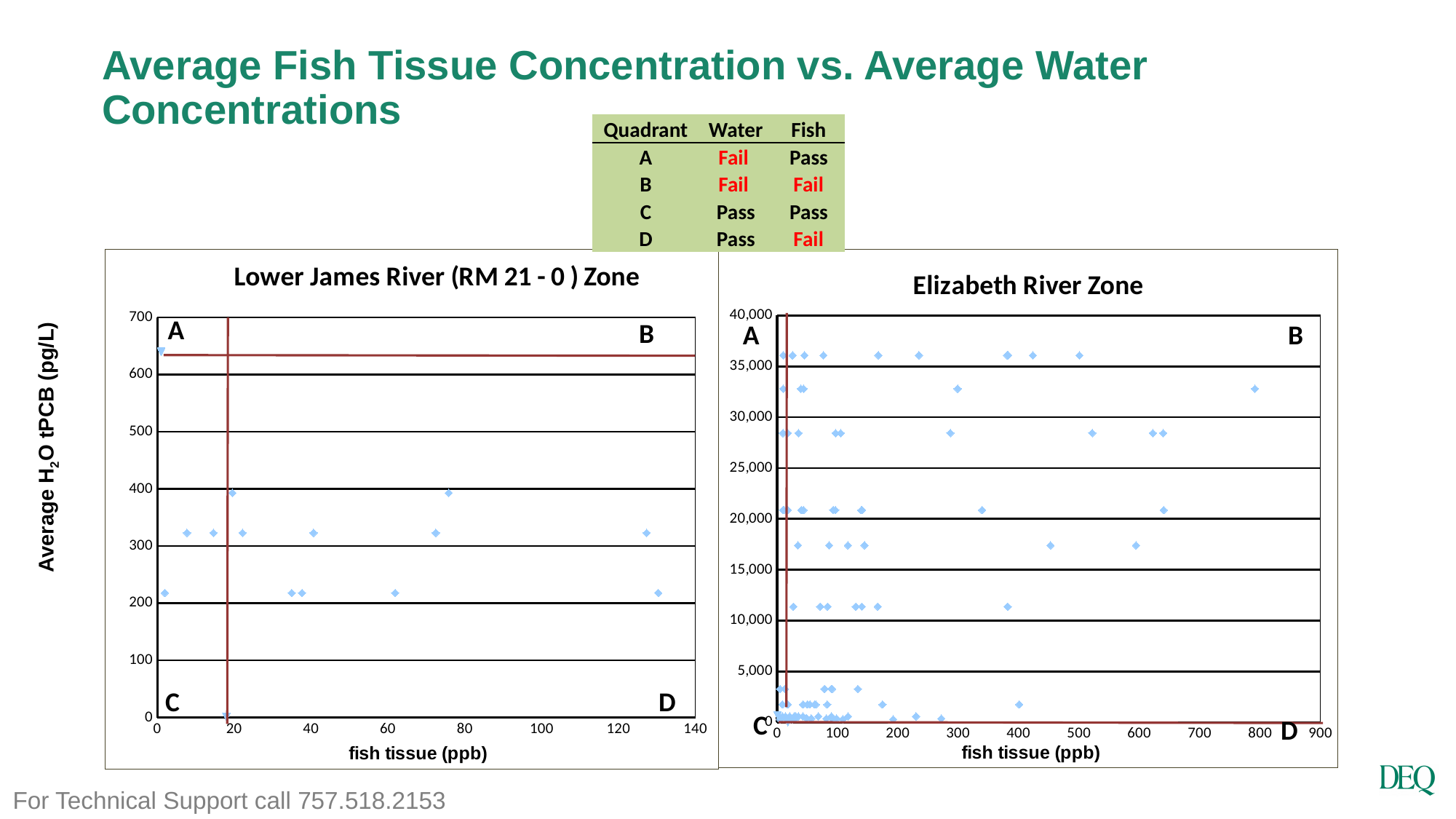
How many scatter charts are shown on the slide? 2 What kind of chart is the Lower James River (RM 21 - 0 ) Zone chart? scatter chart In the Lower James River (RM 21 - 0 ) Zone chart, is the largest fish tissue value plotted greater or less than 120? greater What is the title of the chart on the right of the slide? Elizabeth River Zone What is the label of the horizontal axis on both charts? fish tissue (ppb) Which chart has the larger maximum value on its vertical axis, Lower James River (RM 21 - 0 ) Zone or Elizabeth River Zone? Elizabeth River Zone What kind of chart is the Elizabeth River Zone chart? scatter chart In the Elizabeth River Zone chart, is the largest fish tissue value plotted greater or less than 700? greater In the Lower James River (RM 21 - 0 ) Zone chart, is the highest plotted water concentration greater or less than 600? greater How many quadrants (A, B, C, D) are marked on each chart? 4